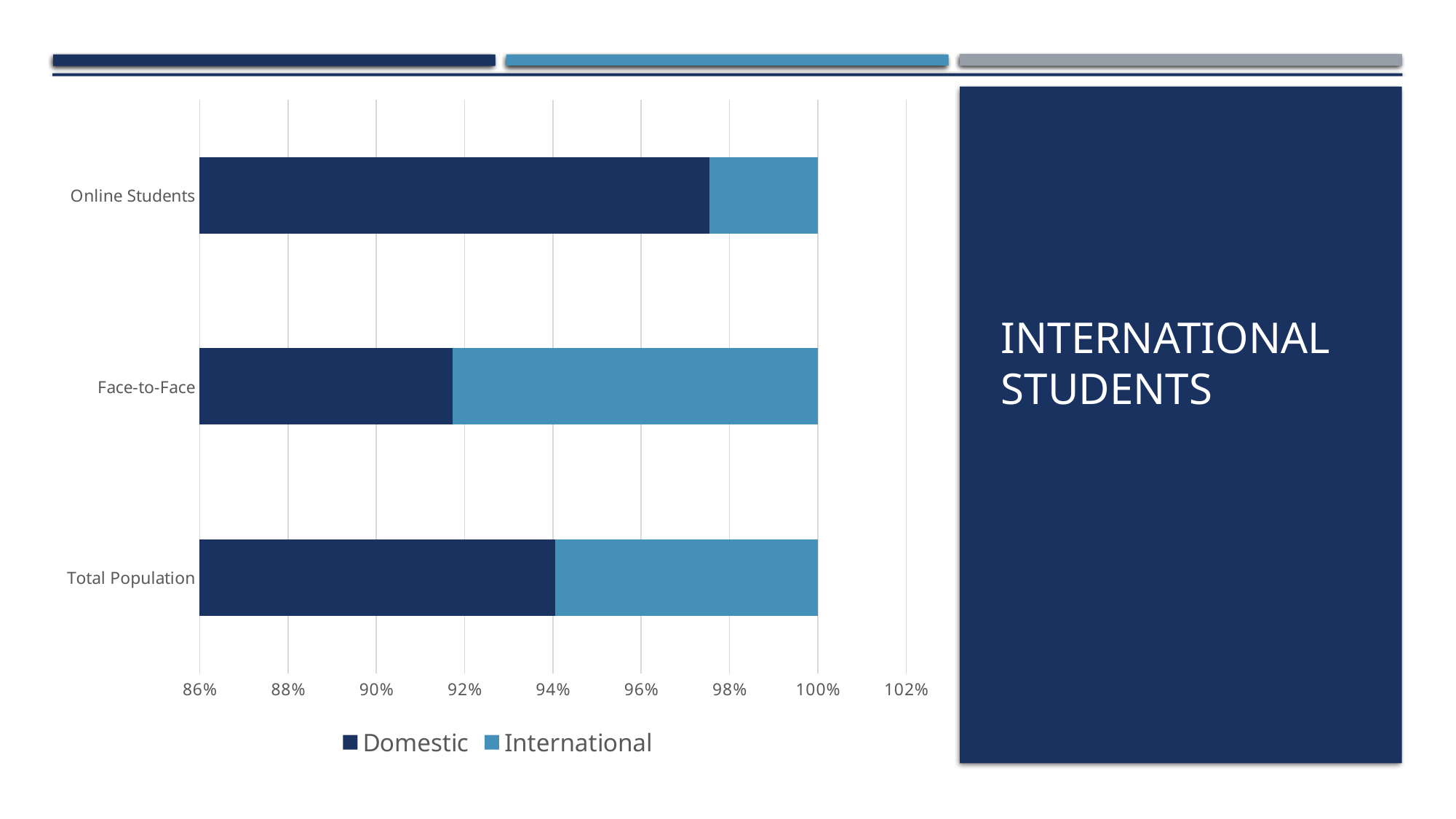
Which category has the smallest Domestic share? Face-to-Face Which is larger, the Domestic share for Online Students or for Face-to-Face? Online Students How many categories are plotted on the chart? 3 Is the Domestic share for Online Students greater or less than 96%? greater What are the two series named in the legend? Domestic and International Is the Domestic share for Total Population greater or less than 96%? less Which category has the largest International share? Face-to-Face What kind of chart is shown on the slide? bar chart Is the Domestic share for Face-to-Face greater or less than 94%? less Which category has the largest Domestic share? Online Students What is the total of the stacked bar for Online Students? 100% How many series does the chart legend list? 2